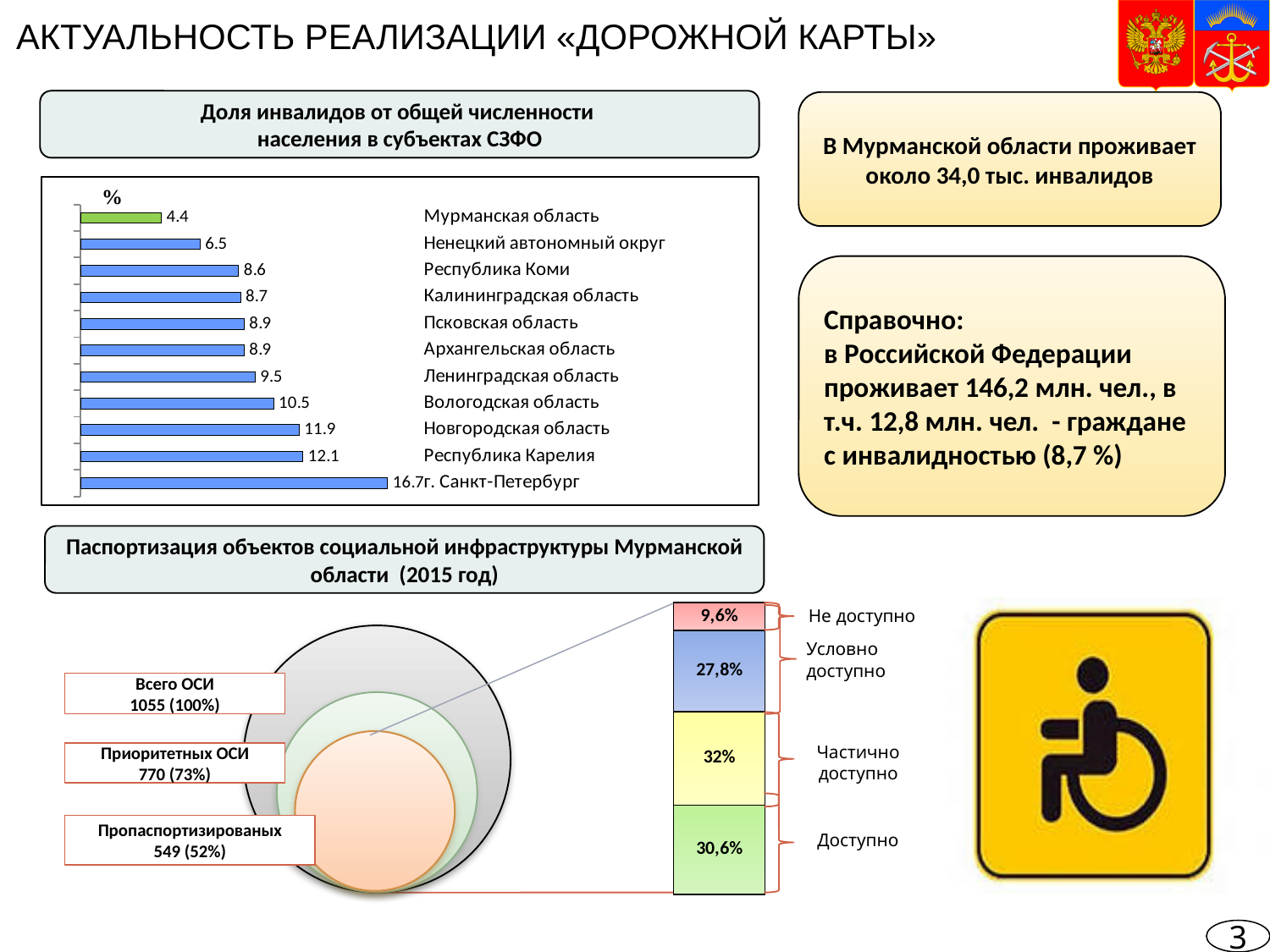
In the chart 'Доля инвалидов от общей численности населения в субъектах СЗФО', which region has the highest value? г. Санкт-Петербург In the chart 'Доля инвалидов от общей численности населения в субъектах СЗФО', which region has the lowest value? Мурманская область In the chart 'Доля инвалидов от общей численности населения в субъектах СЗФО', which is larger: the value for Новгородская область or Вологодская область? Новгородская область In the stacked bar in the 'Паспортизация объектов социальной инфраструктуры Мурманской области (2015 год)' section, what is the share for 'Условно доступно'? 27,8% In the chart 'Доля инвалидов от общей численности населения в субъектах СЗФО', which region's bar is coloured green instead of blue? Мурманская область What kind of chart is 'Доля инвалидов от общей численности населения в субъектах СЗФО'? bar chart In the stacked bar in the 'Паспортизация объектов социальной инфраструктуры Мурманской области (2015 год)' section, which category has the largest share? Частично доступно In the stacked bar in the 'Паспортизация объектов социальной инфраструктуры Мурманской области (2015 год)' section, what is the total of all four segments? 100% In the chart 'Доля инвалидов от общей численности населения в субъектах СЗФО', what is the value for Мурманская область? 4.4 How many regions are shown in the chart 'Доля инвалидов от общей численности населения в субъектах СЗФО'? 11 In the chart 'Доля инвалидов от общей численности населения в субъектах СЗФО', what is the value for Республика Карелия? 12.1 In the chart 'Доля инвалидов от общей численности населения в субъектах СЗФО', what is the difference between the values for г. Санкт-Петербург and Мурманская область? 12.3